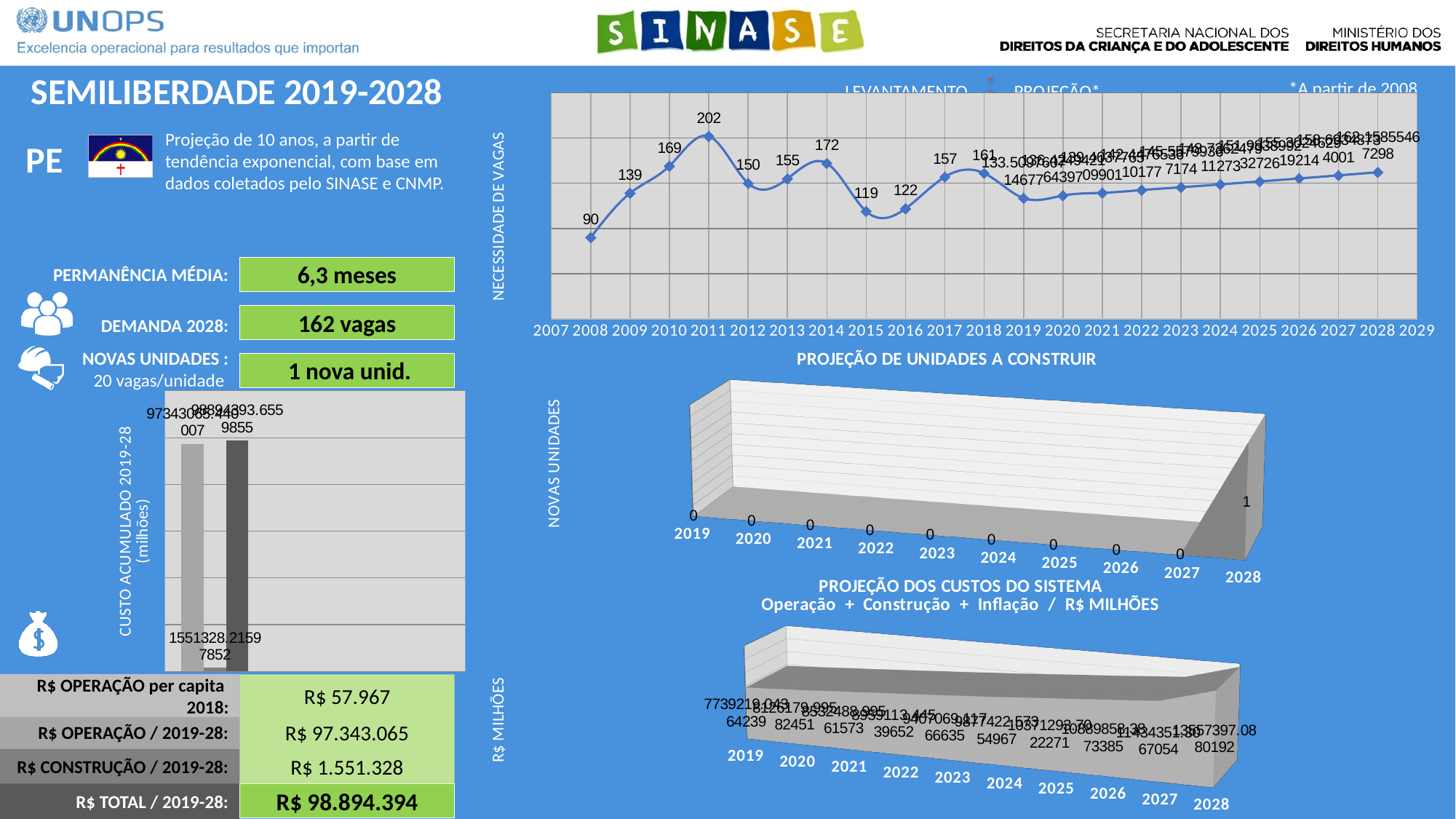
In the NECESSIDADE DE VAGAS line chart, what is the value for 2011? 202 In the NECESSIDADE DE VAGAS line chart, what is the value for 2008? 90 In the NECESSIDADE DE VAGAS line chart, do the values rise or fall from 2008 to 2011? rise In the NECESSIDADE DE VAGAS line chart, which year has the larger value, 2015 or 2016? 2016 What are the two legend entries of the NECESSIDADE DE VAGAS line chart? LEVANTAMENTO and PROJEÇÃO* In the PROJEÇÃO DE UNIDADES A CONSTRUIR chart, what is the value for 2028? 1 How many series does the legend of the NECESSIDADE DE VAGAS line chart list? 2 In the NECESSIDADE DE VAGAS line chart, what is the difference between the values for 2011 and 2010? 33 In the NECESSIDADE DE VAGAS line chart, which year has the lowest value? 2008 How many years are shown on the x axis of the PROJEÇÃO DE UNIDADES A CONSTRUIR chart? 10 In the NECESSIDADE DE VAGAS line chart, which year has the highest value? 2011 What kind of chart is the NECESSIDADE DE VAGAS chart at the top right of the slide? line chart